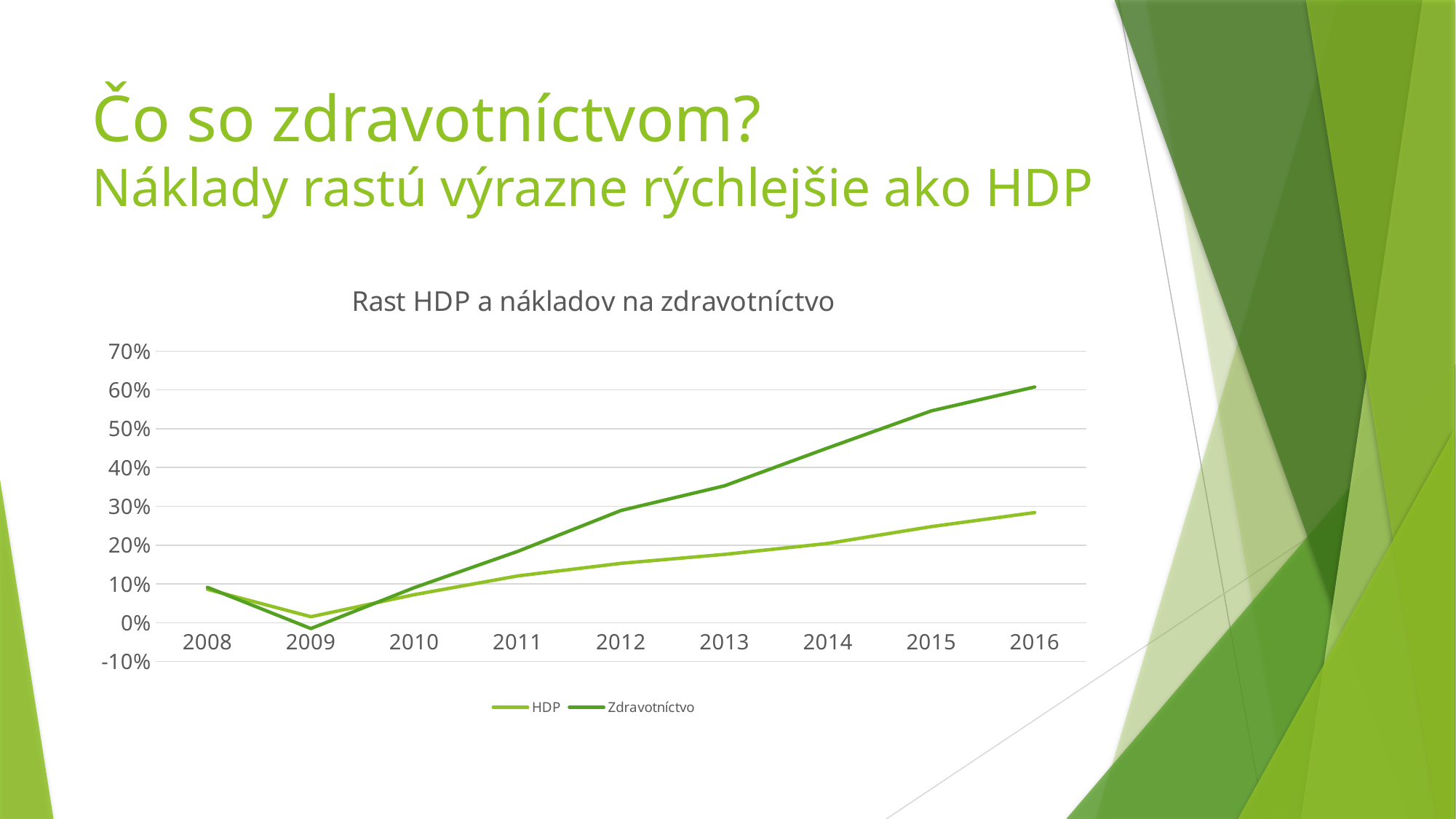
Does the Zdravotníctvo series rise or fall from 2010 to 2016? rise How many series does the legend list? 2 Is the value for HDP in 2012 greater or less than 10%? greater What kind of chart is shown on the slide? line chart What is the title of the chart? Rast HDP a nákladov na zdravotníctvo Is the value for HDP in 2016 greater or less than 40%? less Is the value for Zdravotníctvo in 2016 greater or less than 50%? greater Which series is higher in 2016, HDP or Zdravotníctvo? Zdravotníctvo In which year does the Zdravotníctvo series reach its lowest value? 2009 In which year does the Zdravotníctvo series reach its highest value? 2016 How many years are shown on the x axis? 9